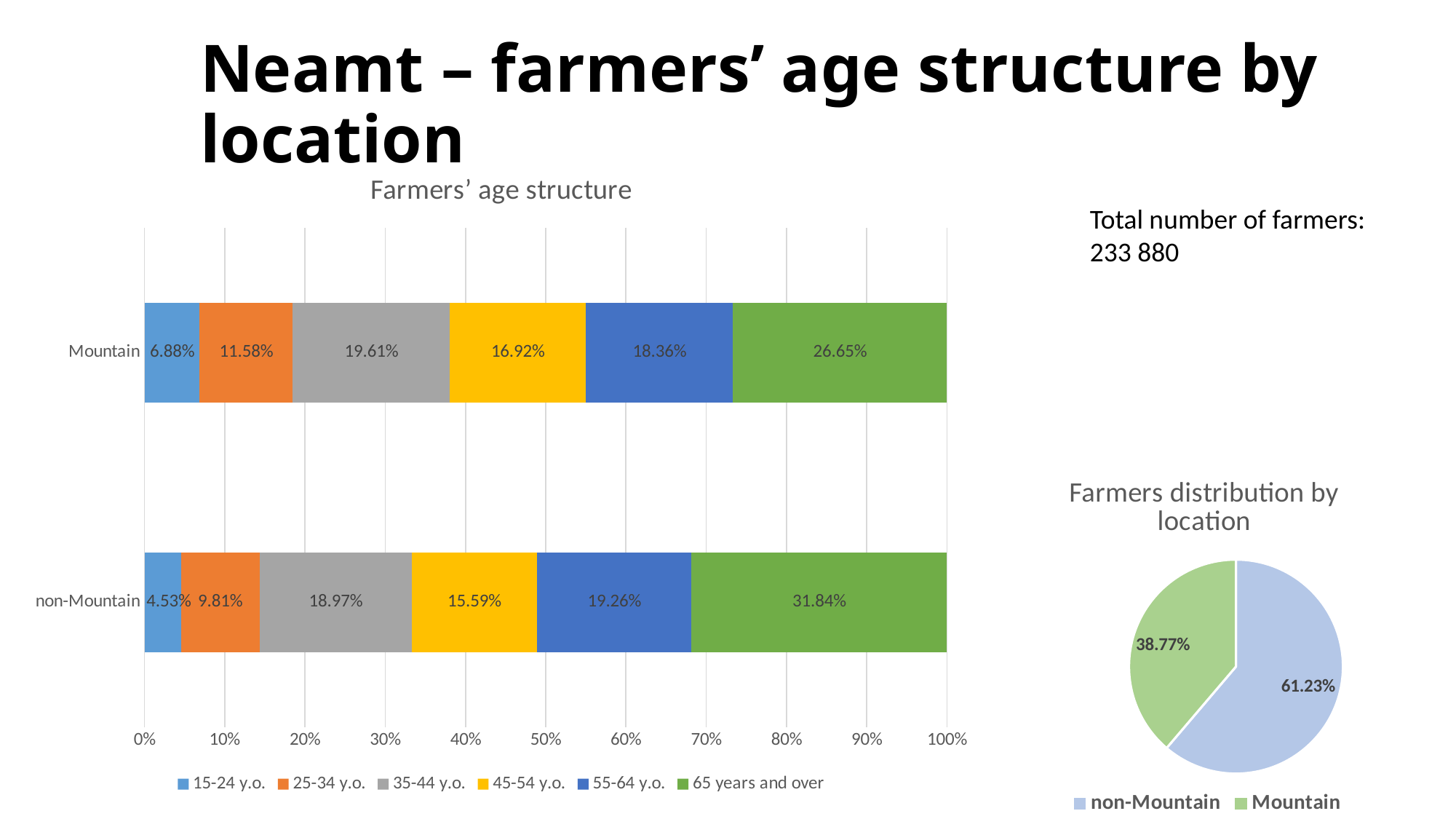
What kind of chart is 'Farmers' age structure'? Stacked bar chart In the 'Farmers' age structure' chart, which age group has the smallest share in the non-Mountain bar? 15-24 y.o. In the 'Farmers' age structure' chart, what is the value for 15-24 y.o. in the non-Mountain bar? 4.53% In the 'Farmers' age structure' chart, what is the value for 35-44 y.o. in the Mountain bar? 19.61% In the 'Farmers distribution by location' pie chart, which slice is larger? non-Mountain In the 'Farmers' age structure' chart, what is the value for 65 years and over in the non-Mountain bar? 31.84% How many series does the legend of the 'Farmers' age structure' chart list? 6 In the 'Farmers distribution by location' pie chart, what share is Mountain? 38.77% In the 'Farmers' age structure' chart, what is the difference between the 65 years and over shares for non-Mountain and Mountain? 5.19% What kind of chart is 'Farmers distribution by location'? Pie chart In the 'Farmers' age structure' chart, which is larger: the 25-34 y.o. share for Mountain or for non-Mountain? Mountain In the 'Farmers' age structure' chart, which age group has the largest share in the Mountain bar? 65 years and over